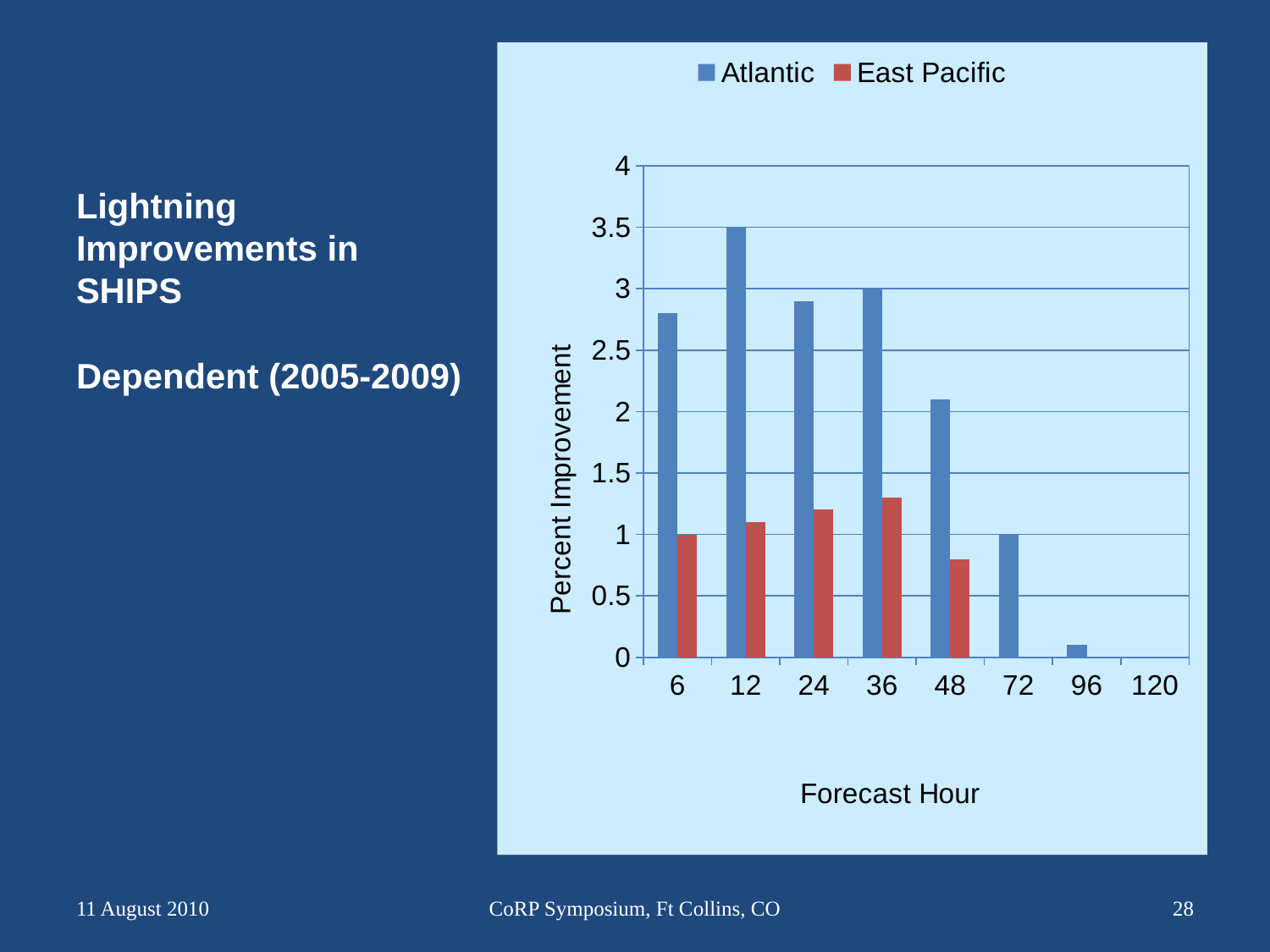
Which series has the larger value at forecast hour 6, Atlantic or East Pacific? Atlantic Is the East Pacific value at forecast hour 36 greater or less than 1? greater Do the Atlantic values rise or fall from forecast hour 48 to forecast hour 120? fall Is the East Pacific value at forecast hour 48 greater or less than 1? less Is the Atlantic value at forecast hour 96 greater or less than 0.5? less At which forecast hour is the Atlantic percent improvement highest? 12 What is the label of the y axis? Percent Improvement What kind of chart is shown on the slide? bar chart How many forecast hour categories are shown on the x axis? 8 What is the label of the x axis? Forecast Hour How many series does the legend list? 2